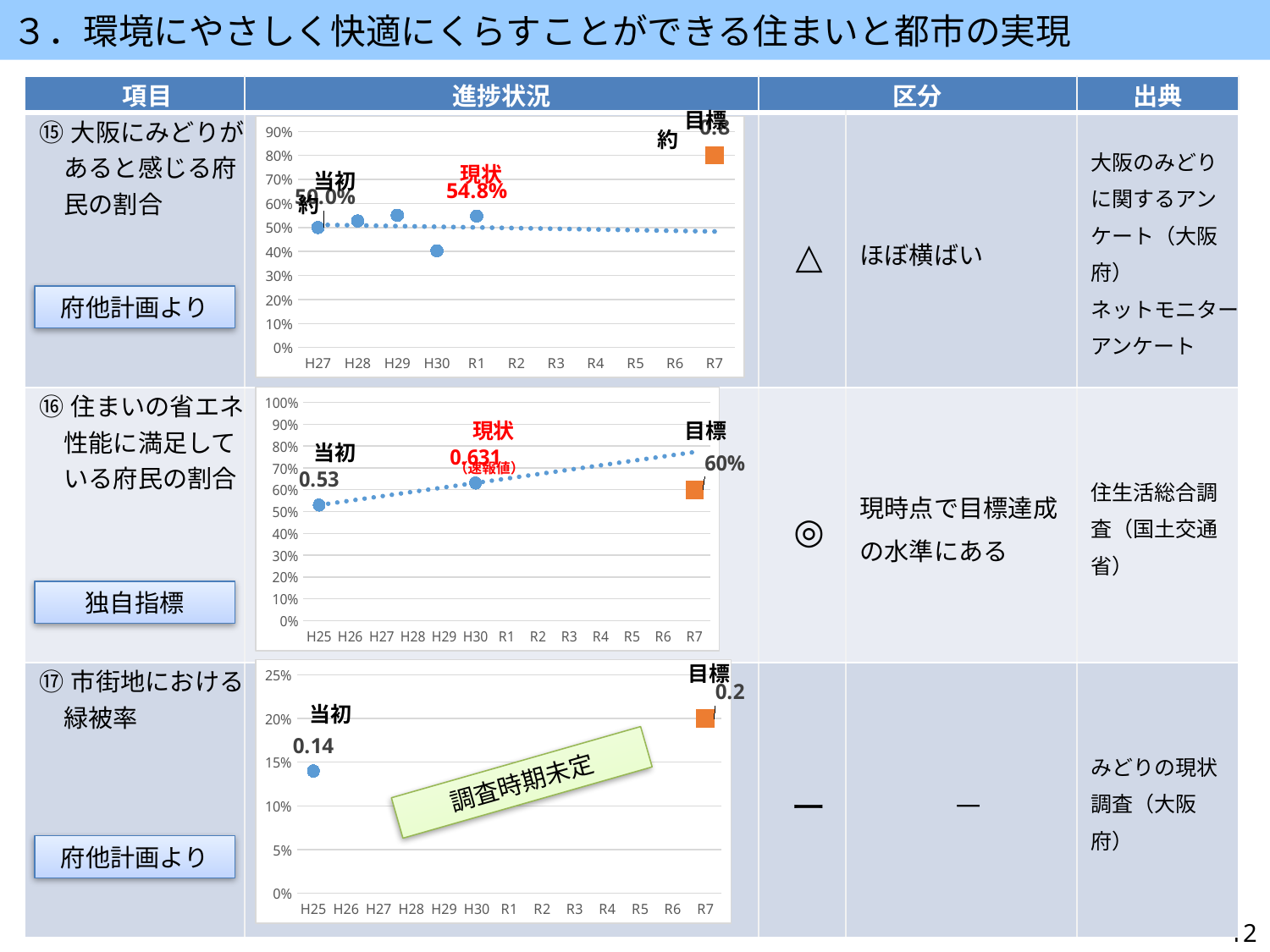
In the chart for ⑯ 住まいの省エネ性能に満足している府民の割合, does the dotted trend line rise or fall from H25 to R7? rise In the chart for ⑯ 住まいの省エネ性能に満足している府民の割合, what value is labelled as 当初? 0.53 In the chart for ⑰ 市街地における緑被率, what value is labelled as 当初? 0.14 In the chart for ⑮ 大阪にみどりがあると感じる府民の割合, is the value plotted at H30 greater or less than 50%? less In the chart for ⑯ 住まいの省エネ性能に満足している府民の割合, what value is labelled as 現状? 0.631 In the chart for ⑮ 大阪にみどりがあると感じる府民の割合, what value is labelled as 当初? 約50.0% In the chart for ⑯ 住まいの省エネ性能に満足している府民の割合, what value is labelled as 目標? 60% In the chart for ⑮ 大阪にみどりがあると感じる府民の割合, what value is labelled as 現状? 54.8% In the chart for ⑰ 市街地における緑被率, what value is labelled as 目標? 0.2 In the chart for ⑯ 住まいの省エネ性能に満足している府民の割合, what is the difference between the 現状 value and the 当初 value? 0.101 In the chart for ⑮ 大阪にみどりがあると感じる府民の割合, how many categories are shown on the x axis? 11 In the chart for ⑰ 市街地における緑被率, what text is written in the green annotation box? 調査時期未定